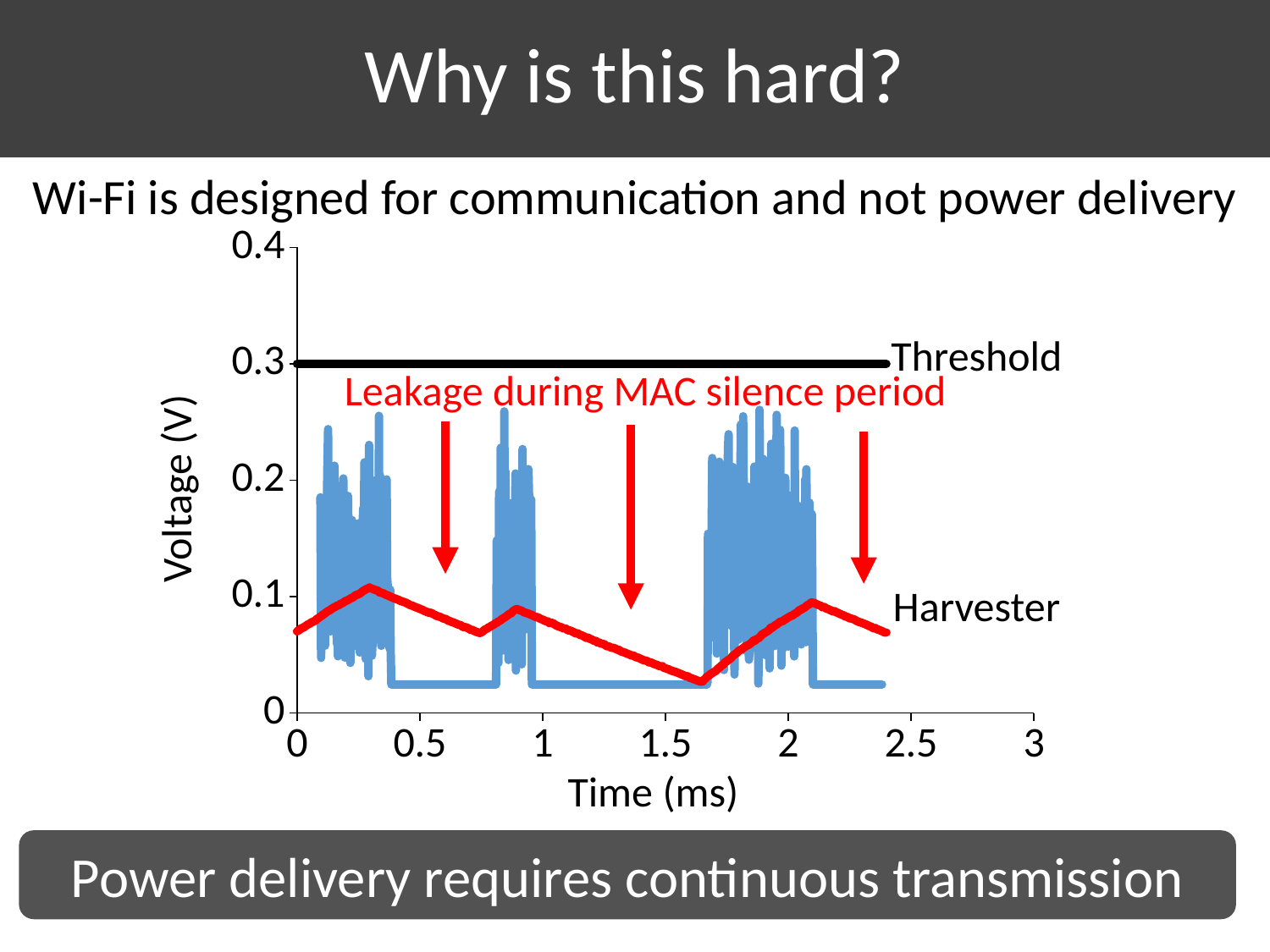
What does the red annotation text above the arrows say? Leakage during MAC silence period Does the Threshold line rise, fall, or stay flat across the time axis? stay flat Is the Harvester voltage at 1.65 ms greater or less than 0.1? less Is the Harvester voltage at 1 ms greater or less than 0.1? less Which is larger at 1 ms, the Threshold line or the Harvester line? Threshold What voltage does the Threshold line sit at? 0.3 What is the highest tick value shown on the Time (ms) axis? 3 Does the Harvester line rise or fall between 1.65 ms and 2.1 ms? rise What kind of chart is shown on the slide? line chart Is the Harvester voltage at 0.3 ms greater or less than 0.2? less Does the Harvester line rise or fall between 0.3 ms and 0.75 ms? fall What is the label of the vertical axis? Voltage (V)